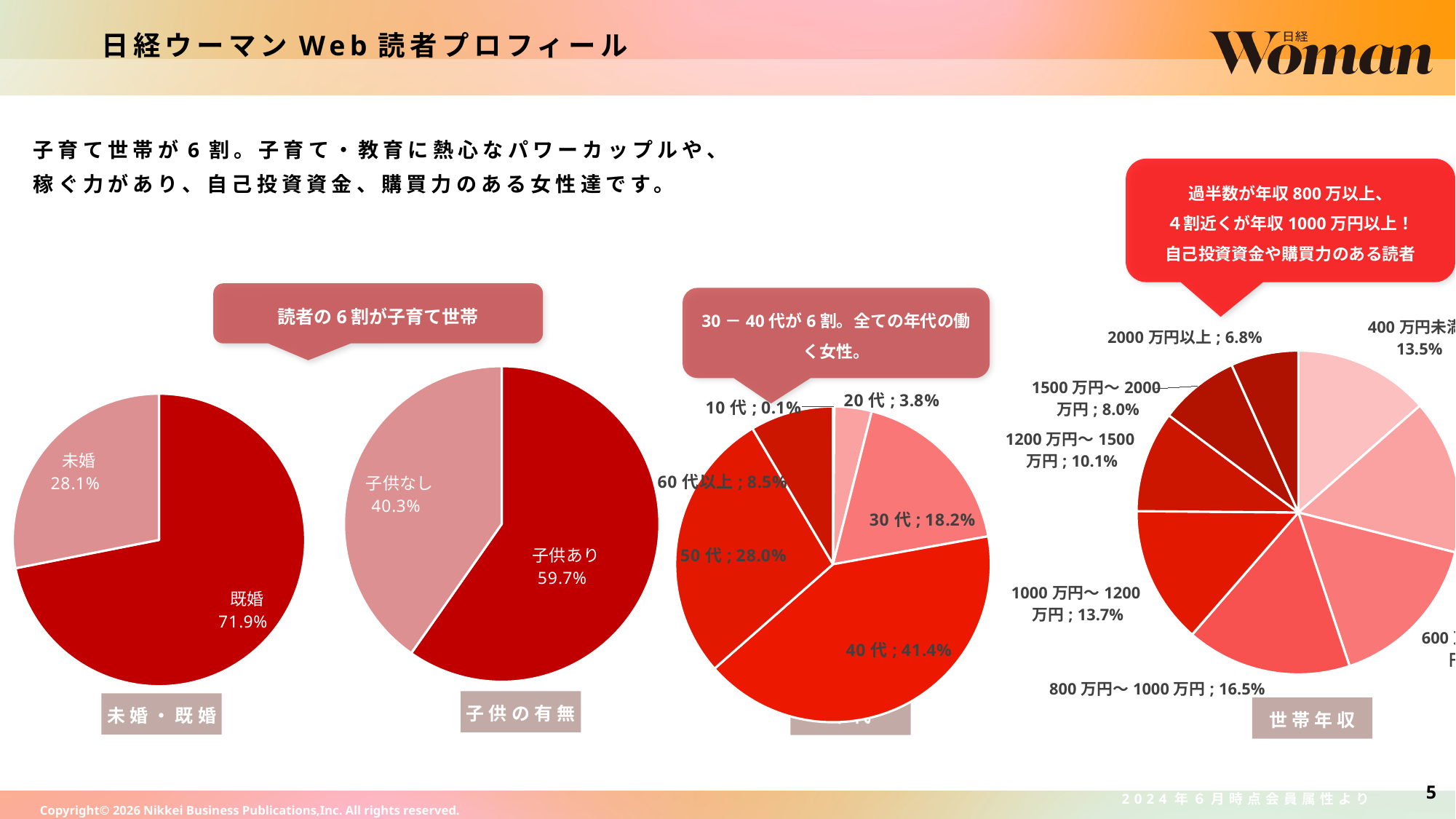
In the third pie chart from the left (age groups), which age group has the largest share? 40代 In the third pie chart from the left (age groups), what is the share for 50代? 28.0% In the third pie chart from the left (age groups), how many age categories are shown? 6 In the third pie chart from the left (age groups), which age group has the smallest share? 10代 What type of chart is used for 未婚・既婚? Pie chart In the 世帯年収 pie chart, what is the share for 800万円〜1000万円? 16.5% In the 子供の有無 pie chart, what is the share for 子供あり? 59.7% In the 世帯年収 pie chart, which is larger: 1200万円〜1500万円 or 2000万円以上? 1200万円〜1500万円 In the 未婚・既婚 pie chart, what percentage is 既婚? 71.9% In the 未婚・既婚 pie chart, what percentage is 未婚? 28.1% In the 世帯年収 pie chart, what is the share for 1500万円〜2000万円? 8.0% In the 子供の有無 pie chart, what is the difference between 子供あり and 子供なし? 19.4%